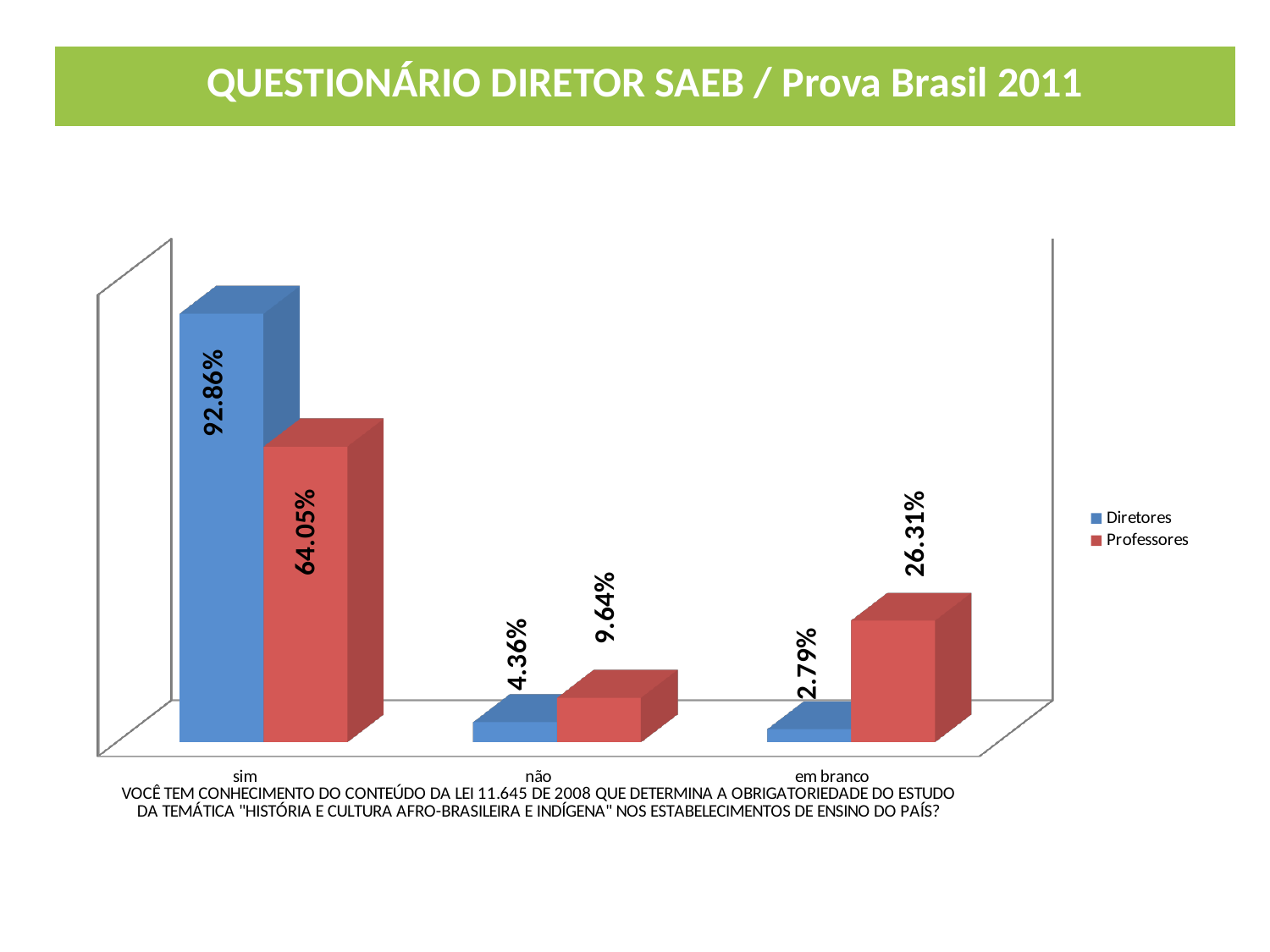
Which series is shown in red in the legend? Professores Which category has the highest value for Diretores? sim Which is larger in the 'em branco' category, Diretores or Professores? Professores Which category has the lowest value for Professores? não What is the value for Diretores in the 'sim' category? 92.86% What is the value for Diretores in the 'não' category? 4.36% What is the difference between the Diretores and Professores values in the 'sim' category? 28.81% How many categories are shown on the x axis? 3 What kind of chart is shown on the slide? bar chart What is the value for Professores in the 'sim' category? 64.05% What is the value for Professores in the 'em branco' category? 26.31% How many series does the legend list? 2